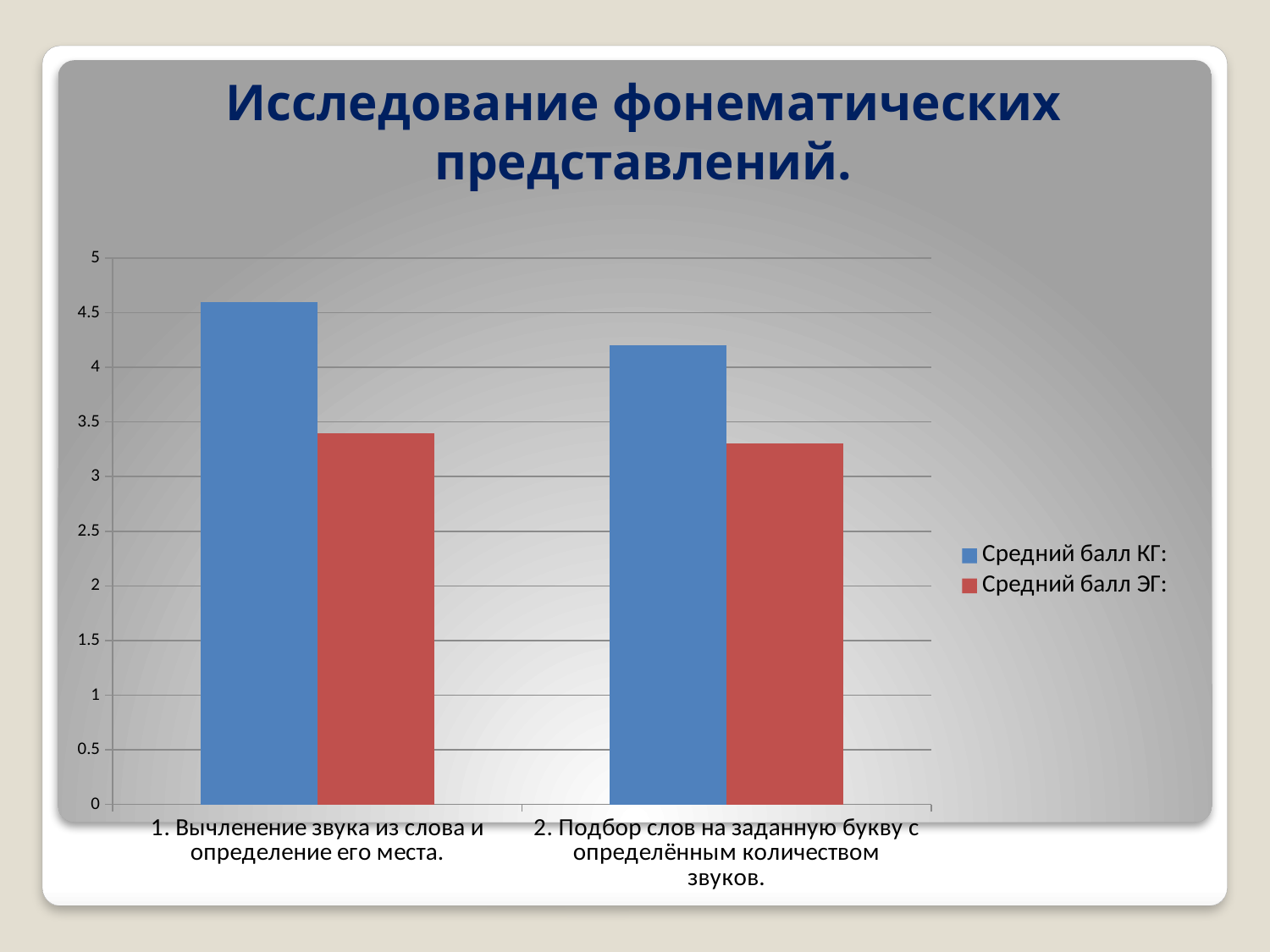
Is the value for Средний балл КГ in category 2 (Подбор слов на заданную букву с определённым количеством звуков) greater or less than 4? greater Is the value for Средний балл ЭГ in category 2 (Подбор слов на заданную букву с определённым количеством звуков) greater or less than 3.5? less Which bar is the tallest in the chart? Средний балл КГ in category 1 (Вычленение звука из слова и определение его места) Is the value for Средний балл ЭГ in category 1 (Вычленение звука из слова и определение его места) greater or less than 4? less What is the title of the chart? Исследование фонематических представлений. In category 1 (Вычленение звука из слова и определение его места), which series has the larger value, Средний балл КГ or Средний балл ЭГ? Средний балл КГ How many series does the legend list? 2 How many categories are shown on the x axis? 2 For the series Средний балл КГ, which category has the higher value? 1. Вычленение звука из слова и определение его места. Which series is shown in red? Средний балл ЭГ: What kind of chart is shown on the slide? bar chart